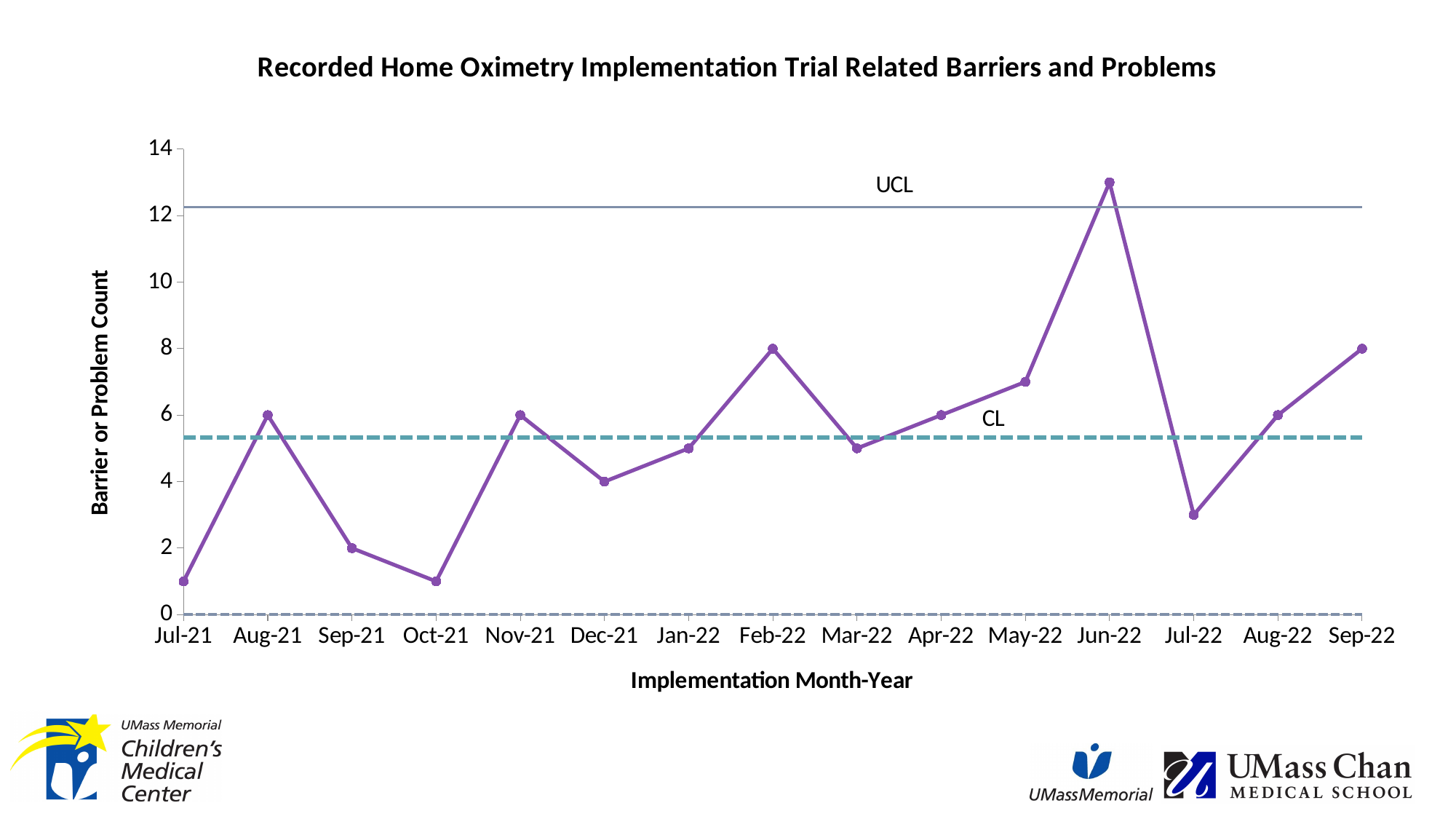
Which has a higher barrier or problem count, Sep-22 or Aug-22? Sep-22 What is the difference between the counts for Feb-22 and Dec-21? 4 What kind of chart is shown on the slide? line chart Is the value for Jun-22 greater or less than 12? greater What is the title of the chart? Recorded Home Oximetry Implementation Trial Related Barriers and Problems How many monthly data points are plotted on the chart? 15 What is the barrier or problem count for Feb-22? 8 Which month has the highest barrier or problem count? Jun-22 What is the label of the y axis? Barrier or Problem Count Is the value for Jul-22 greater or less than 4? less What is the barrier or problem count for Dec-21? 4 What is the barrier or problem count for Sep-21? 2